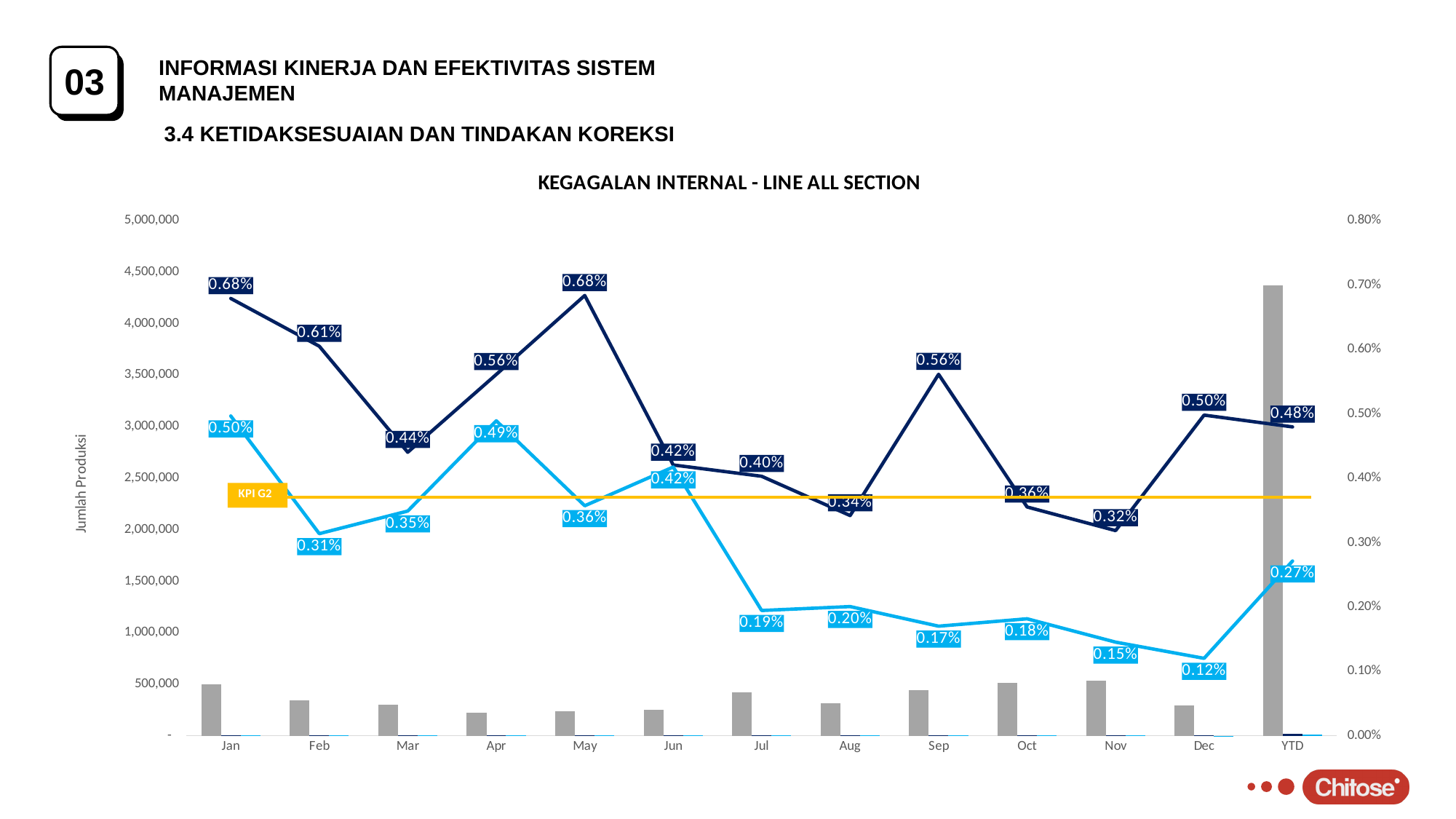
What is the title of the chart? KEGAGALAN INTERNAL - LINE ALL SECTION What kind of chart is shown on the slide? Combined bar and line chart What is the difference between the dark blue line value and the light blue line value for Sep? 0.39% What is the value labelled on the light blue line for Dec? 0.12% What is the value labelled on the dark blue line for Jan? 0.68% What is the label on the left vertical axis? Jumlah Produksi Which month has the lowest value on the light blue line? Dec Is the gray bar for YTD greater or less than 4,000,000? greater Does the dark blue line rise or fall from Jan to Mar? Fall What is the YTD value labelled on the dark blue line? 0.48% How many categories are shown along the x axis of the chart? 13 Which is larger for Apr: the dark blue line value or the light blue line value? The dark blue line value